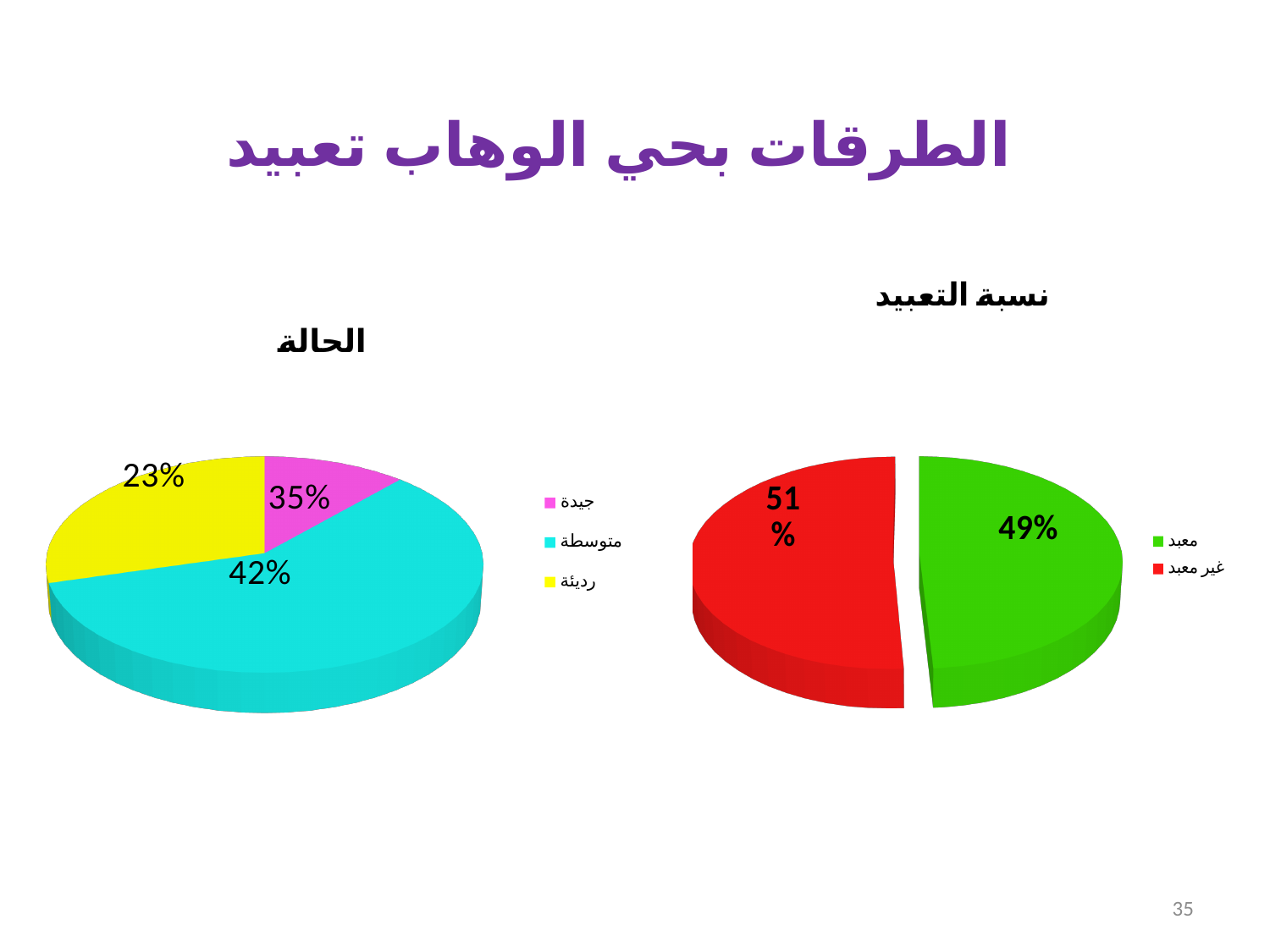
In the chart titled "الحالة", what is the difference between the shares of "متوسطة" and "رديئة"? 19% In the chart titled "الحالة", what percentage is shown for "جيدة"? 35% In the chart titled "الحالة", how many slices does the pie have? 3 In the chart titled "الحالة", what percentage is shown for "رديئة"? 23% In the chart titled "نسبة التعبيد", what percentage is shown for "معبد"? 49% In the chart titled "نسبة التعبيد", what percentage is shown for "غير معبد"? 51% What type of chart is the chart titled "نسبة التعبيد"? Pie chart In the chart titled "نسبة التعبيد", what colour is the "معبد" slice? Green In the chart titled "نسبة التعبيد", which is larger, the share of "معبد" or "غير معبد"? غير معبد In the chart titled "الحالة", which category has the largest share? متوسطة In the chart titled "الحالة", what percentage is shown for "متوسطة"? 42%